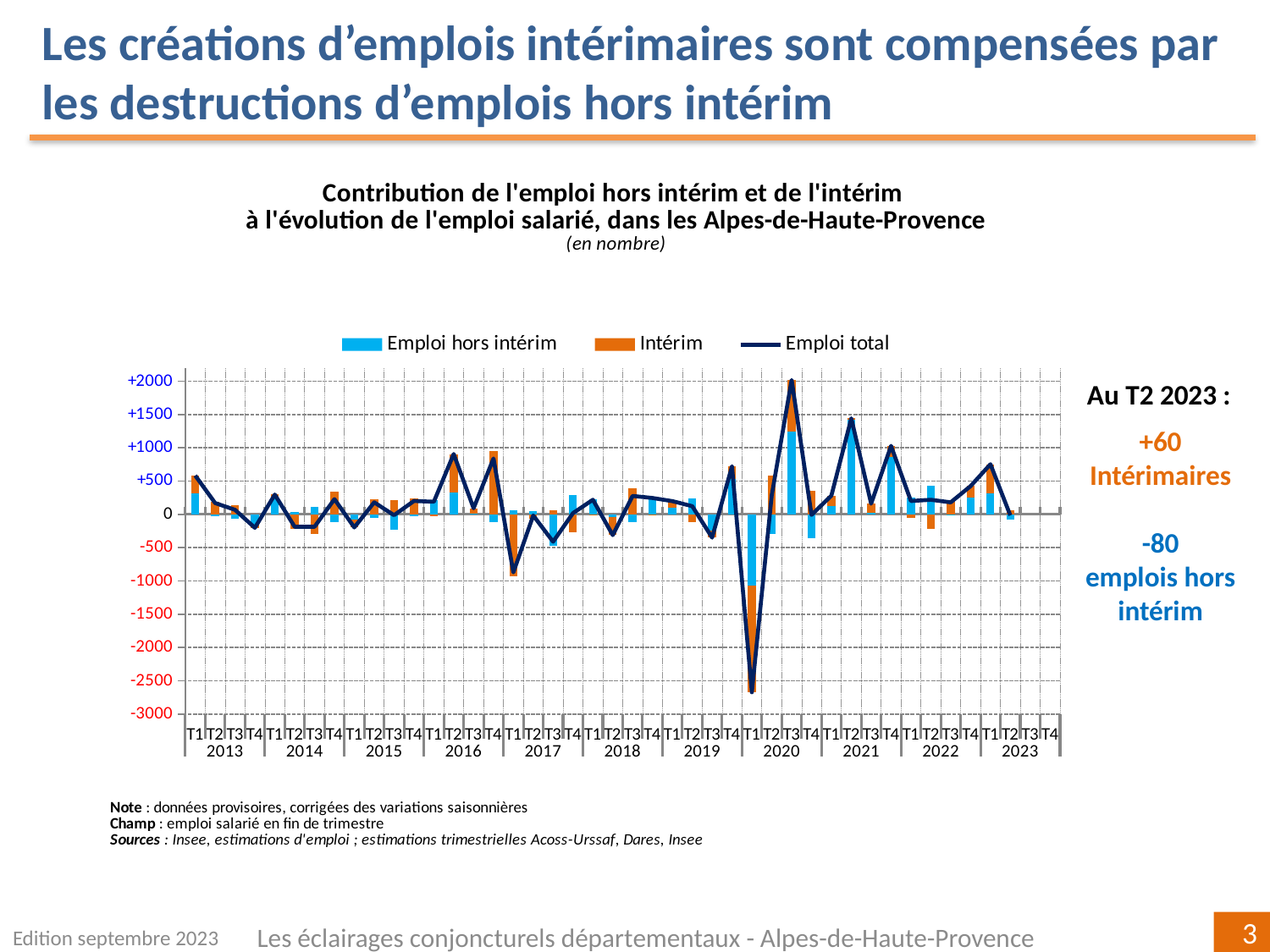
Is the Emploi total value for T3 2020 greater or less than +1500? greater What kind of chart is shown on the slide? A bar chart combined with a line Which series is drawn in orange in the chart? Intérim Which is larger, the Emploi total value for T3 2020 or for T1 2020? T3 2020 How many series does the chart legend list? 3 Is the Emploi total value for T1 2020 greater or less than -2500? less According to the slide, what is the contribution of Intérim in T2 2023? +60 Is the Emploi total value for T1 2017 greater or less than -500? less In which quarter does the Emploi total line reach its lowest point? T1 2020 According to the slide, what is the contribution of emploi hors intérim in T2 2023? -80 In which quarter does the Emploi total line reach its highest point? T3 2020